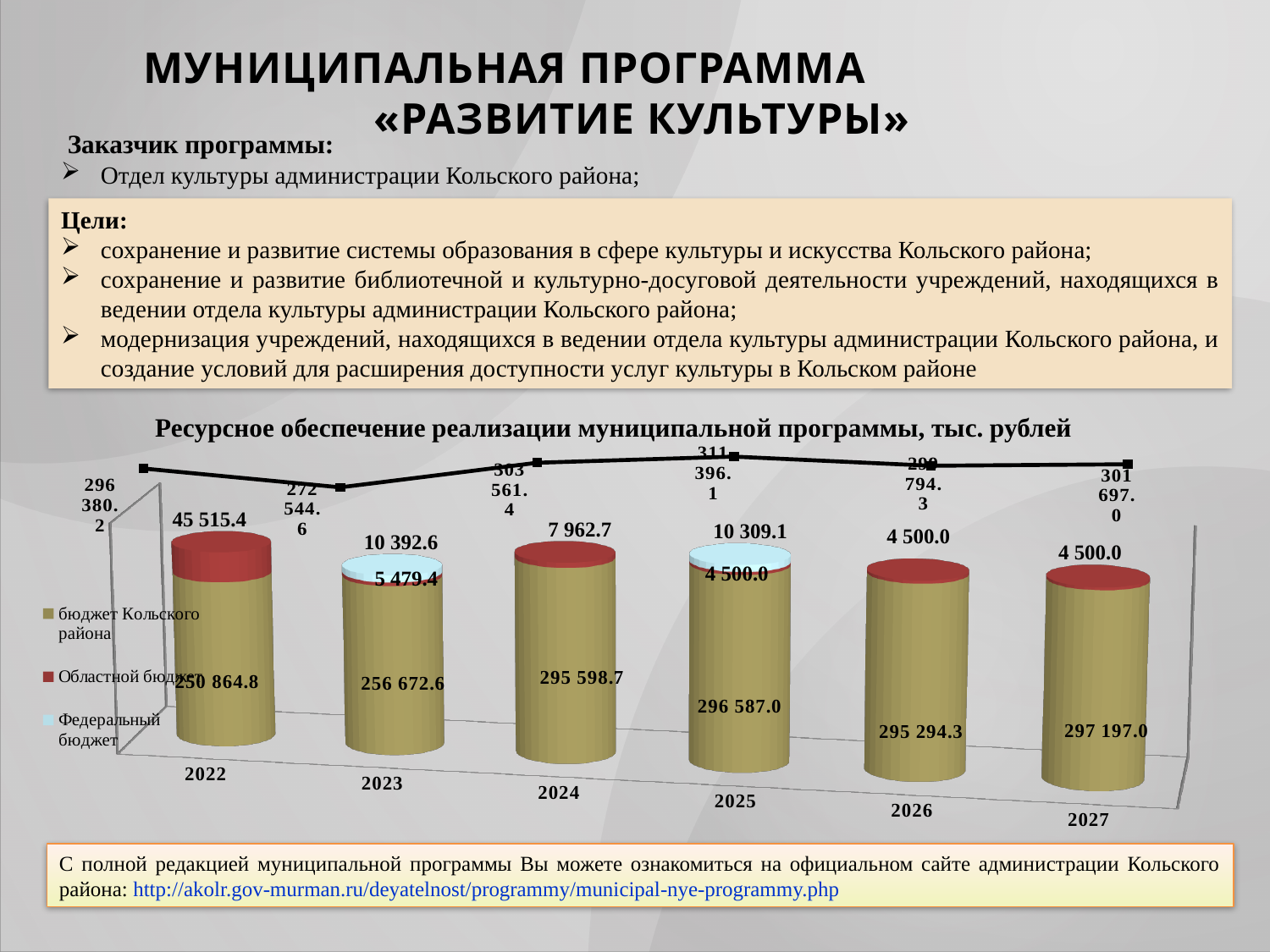
How many series does the chart legend list? 3 What is the value of Федеральный бюджет for 2023? 10 392.6 What is the difference between Областной бюджет in 2022 and in 2023? 40 036.0 What is the value of бюджет Кольского района for 2022? 250 864.8 In which year is бюджет Кольского района the lowest? 2022 What kind of chart is used to show the budget values? bar chart What is the total of the stacked bar for 2023? 272 544.6 Which year has the larger value of бюджет Кольского района, 2025 or 2027? 2027 What is the value of Областной бюджет for 2024? 7 962.7 How many years are shown on the x axis of the chart? 6 In which year is Областной бюджет the highest? 2022 What is the value of Федеральный бюджет for 2025? 10 309.1